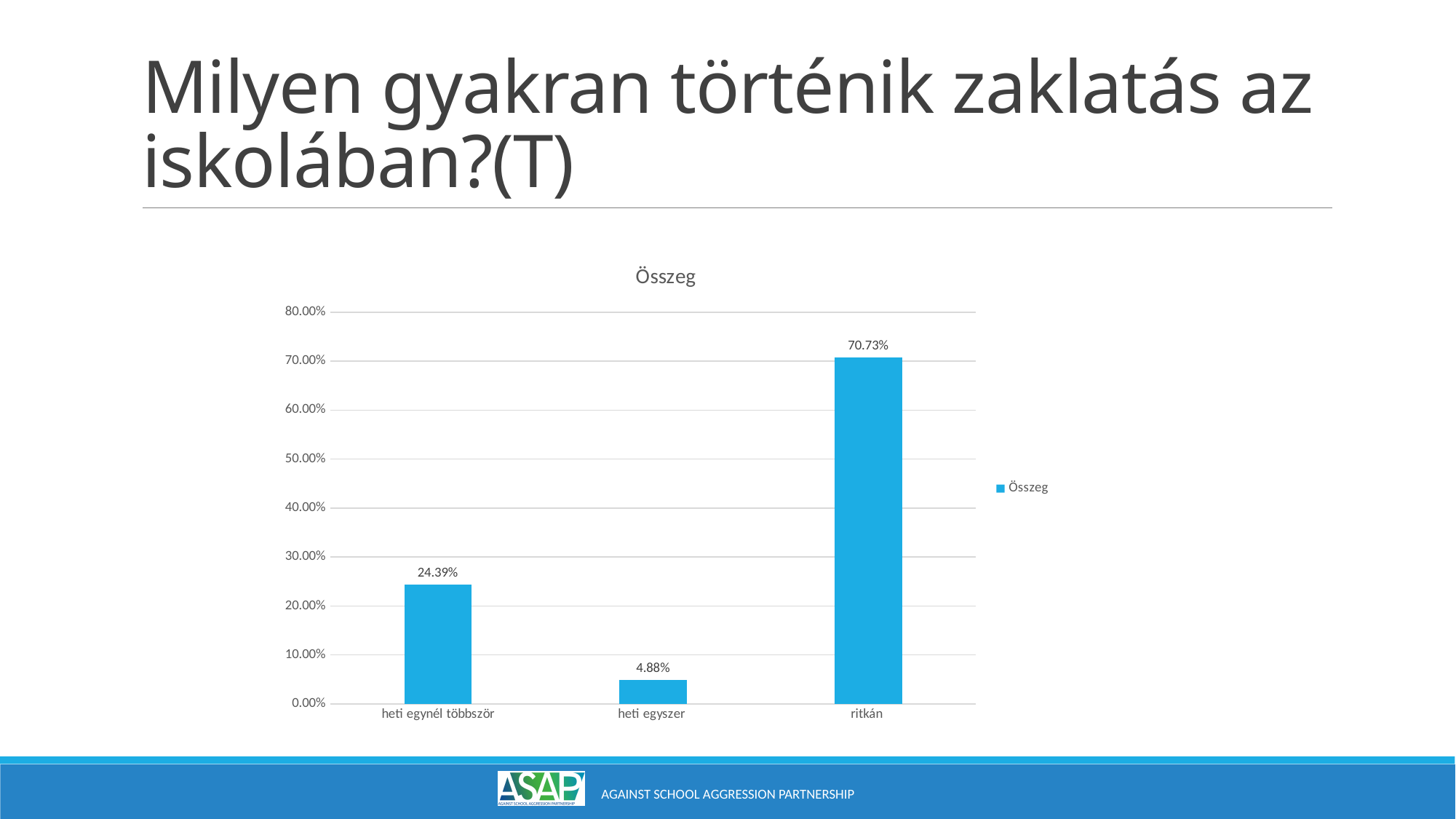
What is the difference between the values for "heti egynél többször" and "heti egyszer"? 19.51% What is the value for "heti egynél többször"? 24.39% Which category has the lowest value? heti egyszer Which is larger, the value for "heti egynél többször" or the value for "heti egyszer"? heti egynél többször What is the value for "ritkán"? 70.73% Which category has the highest value? ritkán What is the value for "heti egyszer"? 4.88% What is the difference between the values for "ritkán" and "heti egynél többször"? 46.34% What kind of chart is shown on the slide? bar chart How many categories are shown on the x axis? 3 Is the value for "ritkán" greater or less than 60.00%? greater What is the title of the chart? Összeg